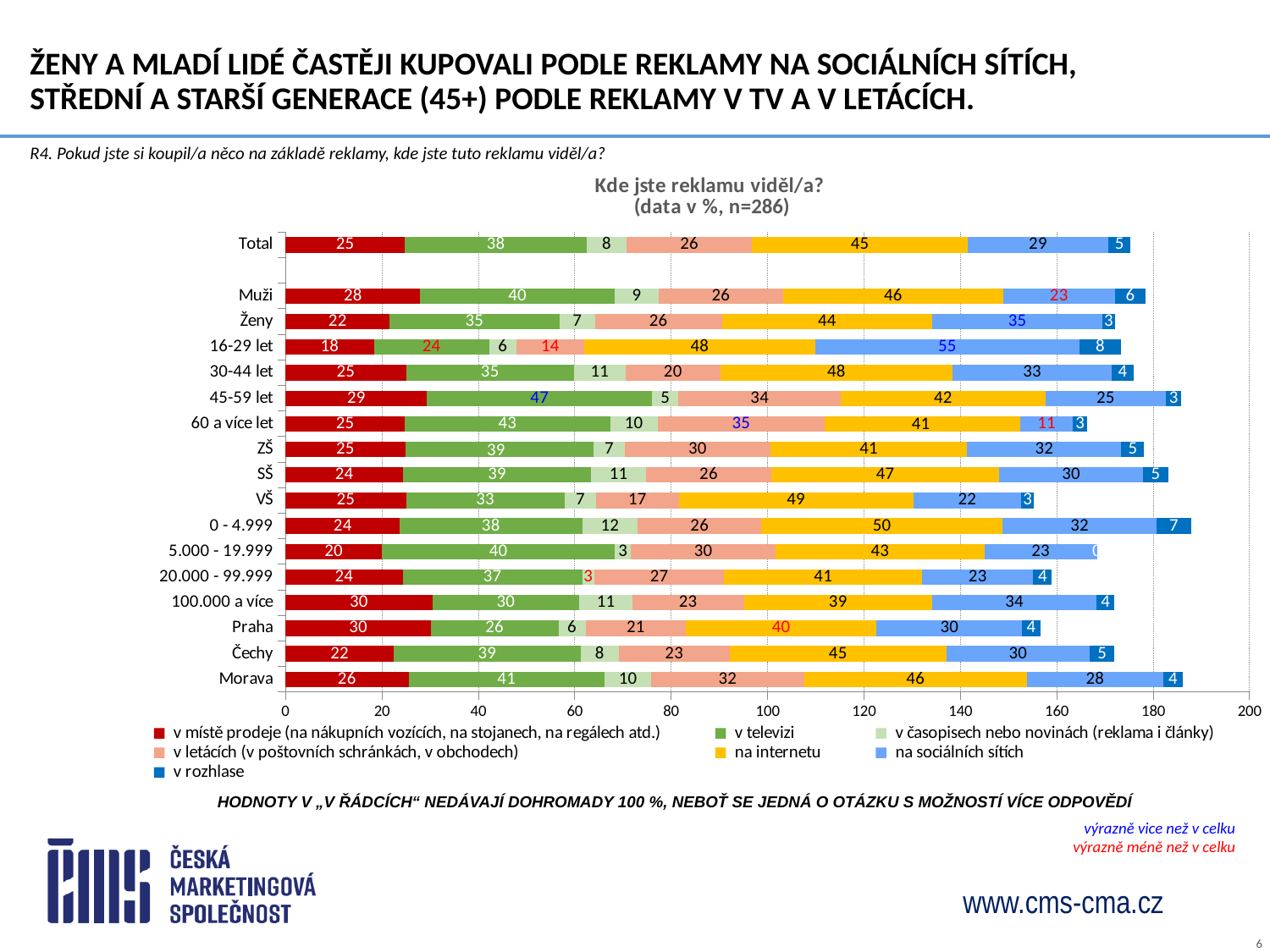
Which category has the highest value for 'na sociálních sítích'? 16-29 let How many series does the legend list? 7 What kind of chart is shown on the slide? Stacked bar chart What is the total of the stacked bar for the Total row? 176 What is the difference between the 'v letácích' values for '45-59 let' and '16-29 let'? 20 Which category has the lowest value for 'na sociálních sítích'? 60 a více let Which has a larger value for 'v televizi': Praha or Morava? Morava What is the value for 'v televizi' in the '45-59 let' row? 47 What is the difference between the 'na sociálních sítích' values for Ženy and Muži? 12 How many categories (rows) are shown on the chart? 17 What is the value for 'na sociálních sítích' in the '16-29 let' row? 55 What is the value for 'na internetu' in the Total row? 45